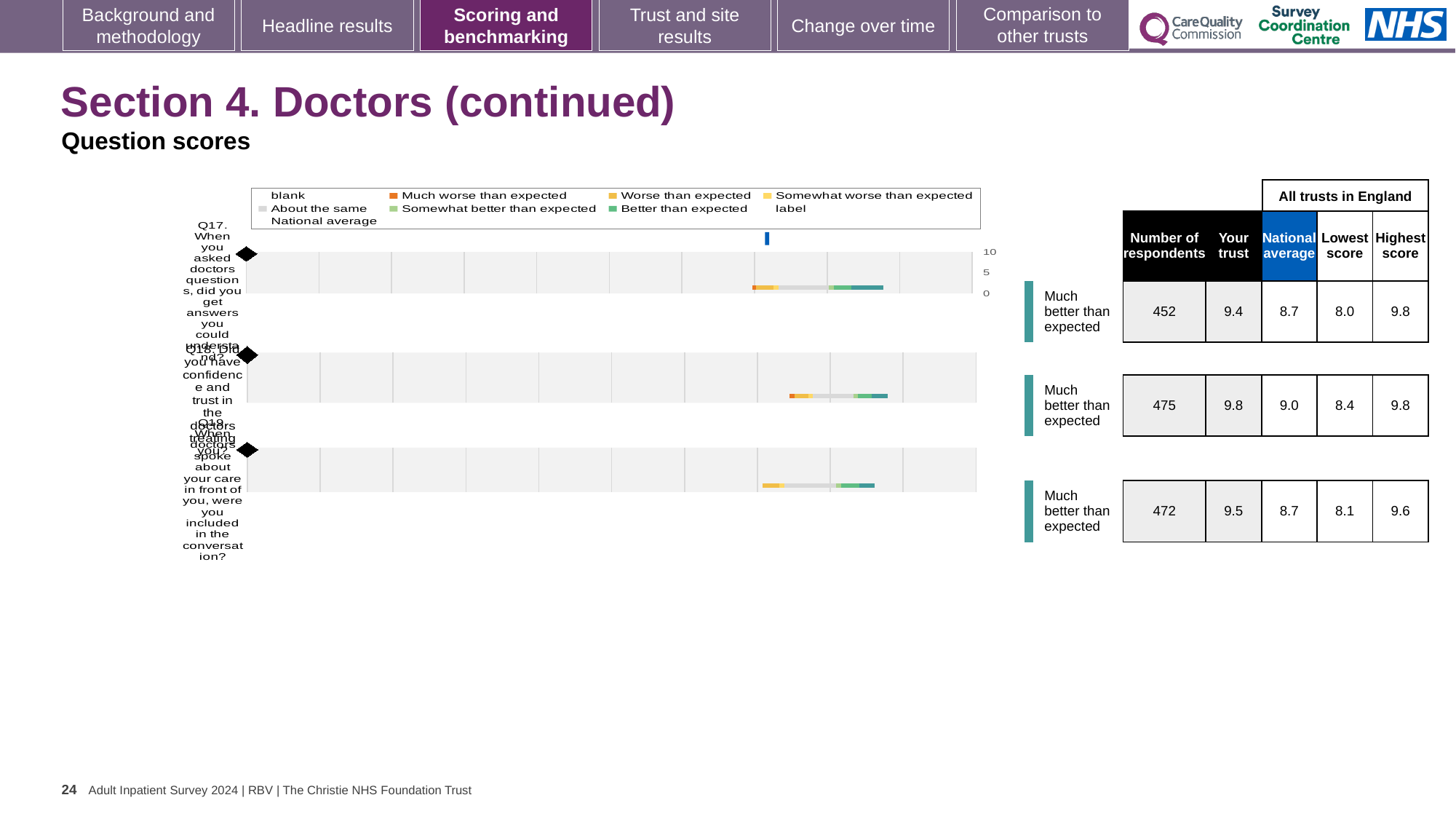
Which question has the lowest number of respondents? Q17 Which has the higher 'Your trust' score, Q17 or Q19? Q19 Which question has the highest 'Your trust' score? Q18 What is the national average score for Q18 (Did you have confidence and trust in the doctors treating you?)? 9.0 What is the difference between the 'Your trust' score and the national average for Q18? 0.8 What colour does the legend use for 'Much worse than expected'? orange How many respondents answered Q19 (When doctors spoke about your care in front of you, were you included in the conversation?)? 472 What is the highest score among all trusts in England for Q19? 9.6 What kind of chart is used to show the question scores for Q17, Q18 and Q19? bar chart What is the 'Your trust' score for Q17 (When you asked doctors questions, did you get answers you could understand?)? 9.4 How many questions are plotted in the chart? 3 What is the highest value shown on the chart's score axis? 10